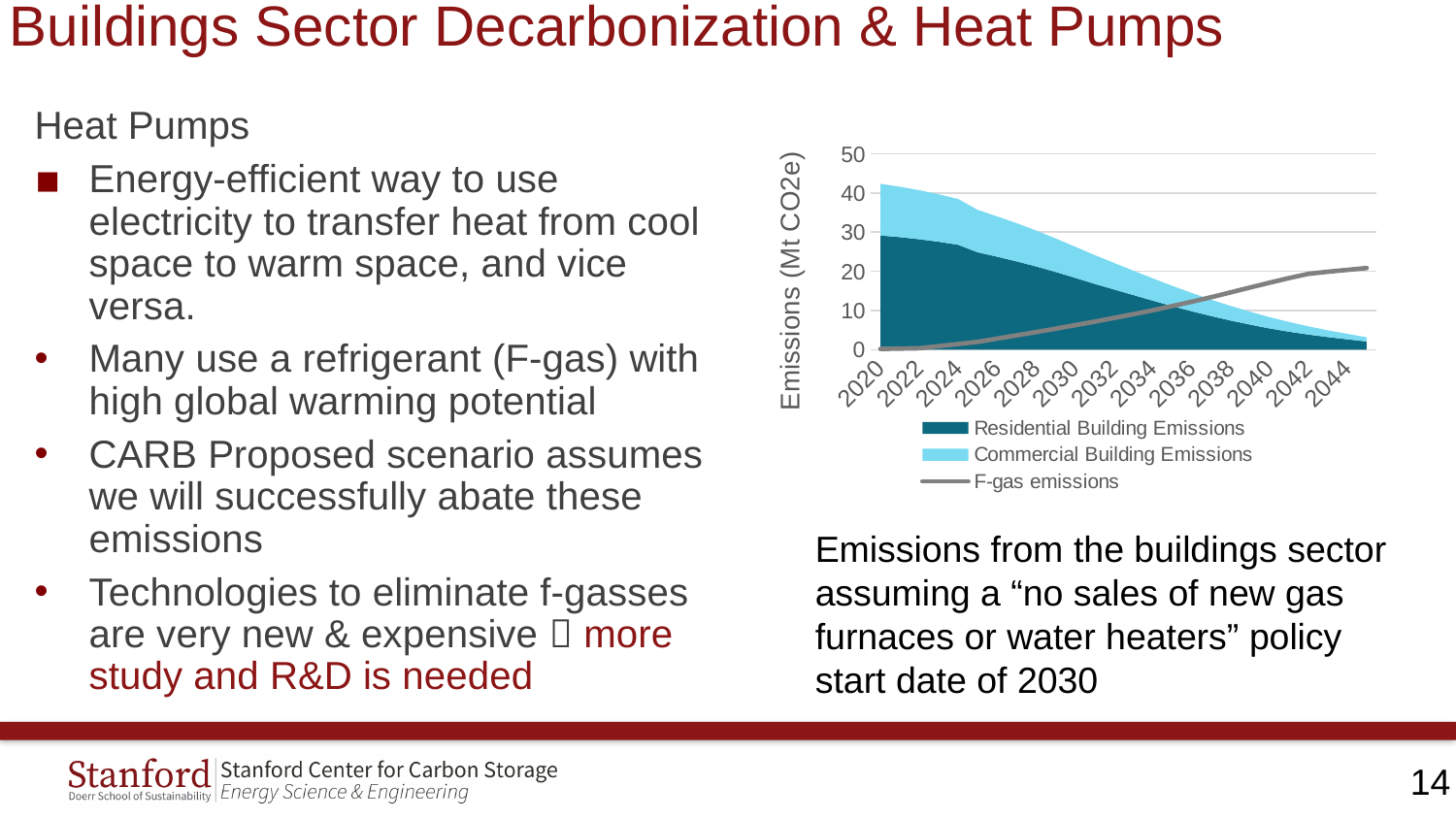
Which series in the chart is drawn as a grey line rather than a shaded area? F-gas emissions What is the label on the chart's vertical axis? Emissions (Mt CO2e) How many series does the chart legend list? 3 Is the total of residential and commercial building emissions in 2020 greater or less than 40? greater What kind of chart is shown on the slide? combination area and line chart Is the value for F-gas emissions in 2030 greater or less than 10? less Is the value for Residential Building Emissions in 2044 greater or less than 10? less How many year labels are shown on the chart's x axis? 13 Do F-gas emissions rise or fall from 2020 to 2044? rise Do Residential Building Emissions rise or fall from 2020 to 2044? fall What is the first year shown on the chart's x axis? 2020